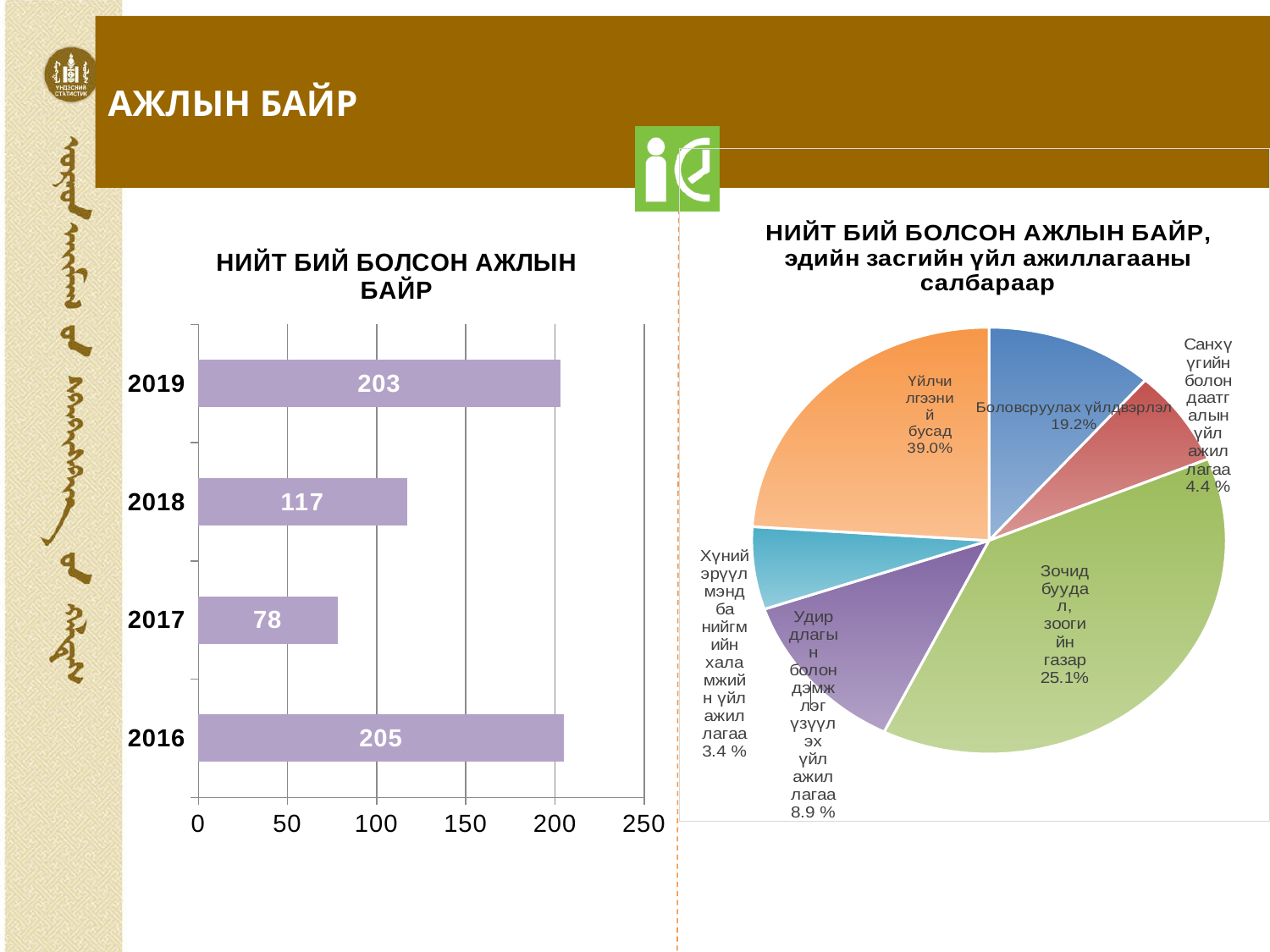
In the pie chart on the right, what share does 'Зочид буудал, зоогийн газар' have? 25.1% In the bar chart 'НИЙТ БИЙ БОЛСОН АЖЛЫН БАЙР', which year has the highest value? 2016 In the bar chart 'НИЙТ БИЙ БОЛСОН АЖЛЫН БАЙР', what is the value for 2019? 203 In the pie chart on the right, which sector has the smallest share? Хүний эрүүл мэнд ба нийгмийн халамжийн үйл ажиллагаа In the bar chart 'НИЙТ БИЙ БОЛСОН АЖЛЫН БАЙР', which year has the lowest value? 2017 In the pie chart on the right, what share does 'Үйлчилгээний бусад' have? 39.0% In the bar chart 'НИЙТ БИЙ БОЛСОН АЖЛЫН БАЙР', how many years are shown? 4 In the bar chart 'НИЙТ БИЙ БОЛСОН АЖЛЫН БАЙР', which is larger, the value for 2018 or the value for 2019? 2019 What kind of chart is the chart on the left of the slide? bar chart In the bar chart 'НИЙТ БИЙ БОЛСОН АЖЛЫН БАЙР', what is the value for 2017? 78 In the bar chart 'НИЙТ БИЙ БОЛСОН АЖЛЫН БАЙР', what is the difference between the values for 2018 and 2017? 39 In the pie chart on the right, how many slices are there? 6